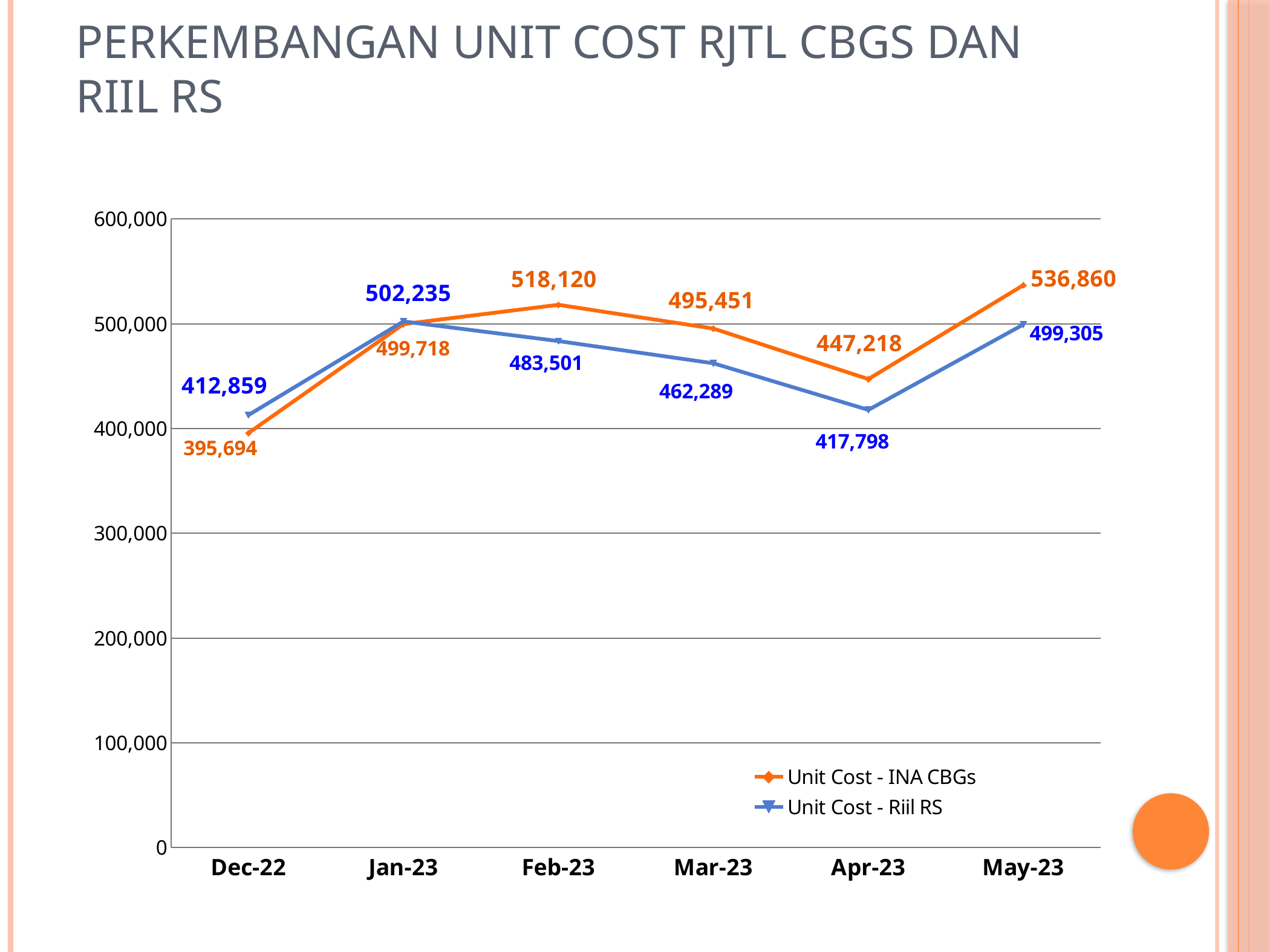
What is the Unit Cost - INA CBGs value for Feb-23? 518,120 In which month is Unit Cost - Riil RS lowest? Dec-22 What is the Unit Cost - INA CBGs value for Dec-22? 395,694 How many months are plotted on the x axis? 6 In which month is Unit Cost - Riil RS highest? Jan-23 Does Unit Cost - Riil RS rise or fall from Jan-23 to Apr-23? fall What type of chart is shown on the slide? line chart What is the difference between Unit Cost - INA CBGs and Unit Cost - Riil RS in May-23? 37,555 Which series has the larger value in Dec-22, Unit Cost - INA CBGs or Unit Cost - Riil RS? Unit Cost - Riil RS What is the Unit Cost - Riil RS value for Apr-23? 417,798 How many series does the legend list? 2 In which month is Unit Cost - INA CBGs highest? May-23